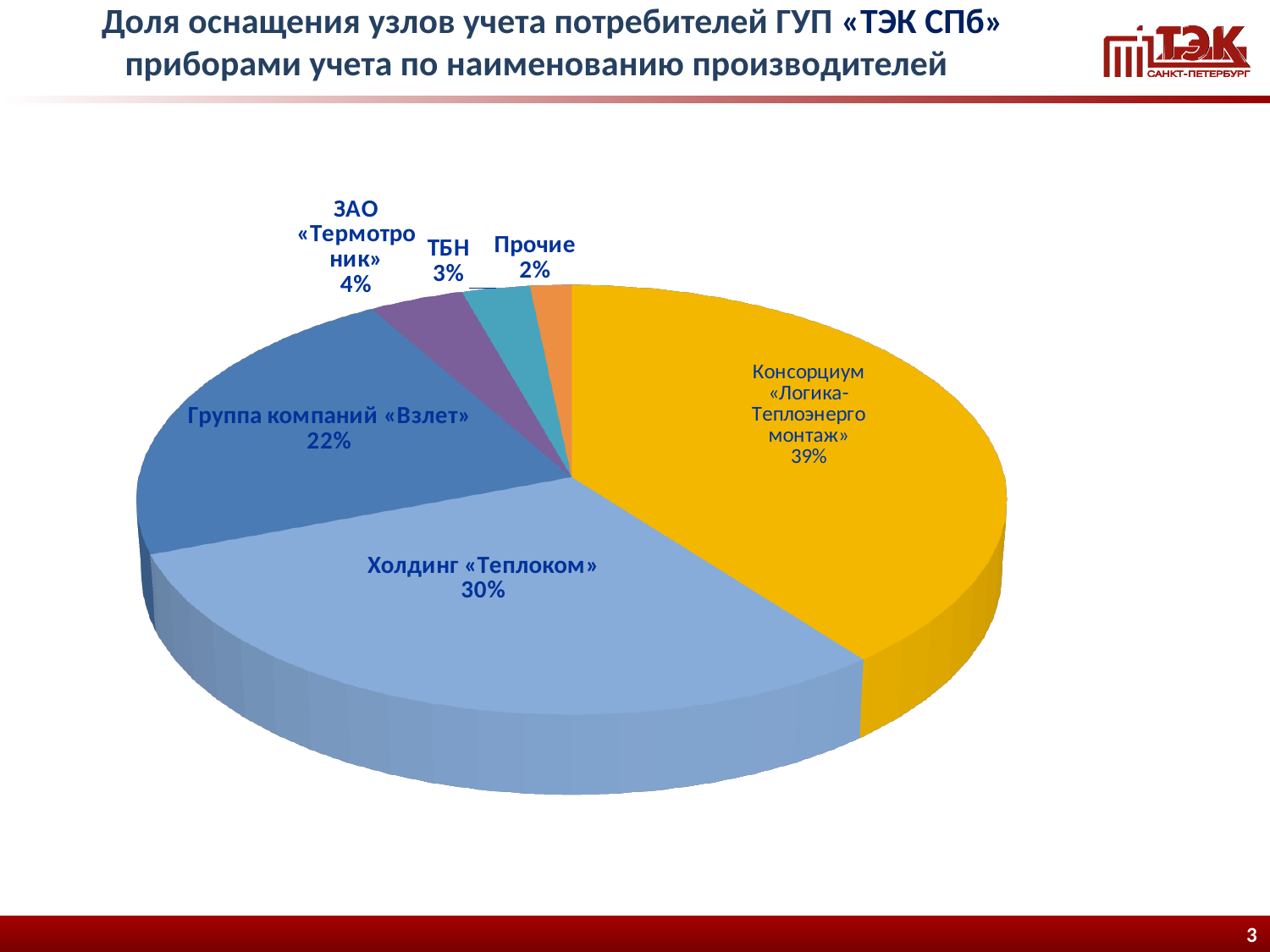
Which category has the largest share of the pie? Консорциум «Логика-Теплоэнергомонтаж» What share does Холдинг «Теплоком» have? 30% What share does ЗАО «Термотроник» have? 4% Which category has the smallest share of the pie? Прочие What share does Консорциум «Логика-Теплоэнергомонтаж» have? 39% What type of chart is shown on the slide? Pie chart What share does ТБН have? 3% What colour is the slice for Консорциум «Логика-Теплоэнергомонтаж»? Yellow What is the difference in share between Консорциум «Логика-Теплоэнергомонтаж» and Холдинг «Теплоком»? 9% How many slices does the pie chart have? 6 Which has a larger share: Группа компаний «Взлет» or Холдинг «Теплоком»? Холдинг «Теплоком» What share does Группа компаний «Взлет» have? 22%